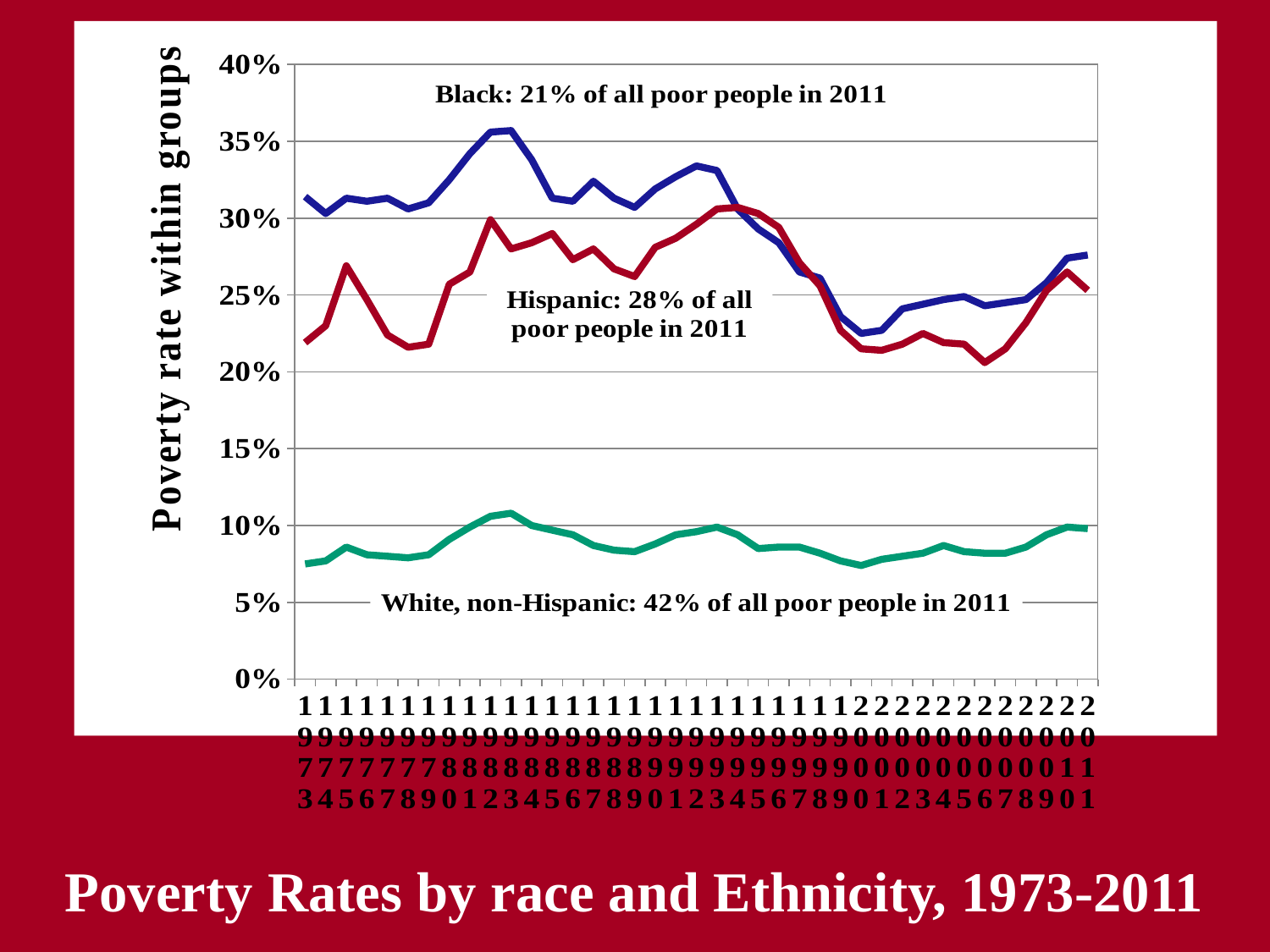
Which group has the lowest poverty rate across the whole period shown? White, non-Hispanic According to the chart annotation, what share of all poor people in 2011 were White, non-Hispanic? 42% What is the title of the slide? Poverty Rates by race and Ethnicity, 1973-2011 What kind of chart is shown on the slide? line chart What is the label on the vertical axis? Poverty rate within groups Is the poverty rate for the Black group in 1982 greater or less than 30%? greater In 1973, which group had the higher poverty rate, Black or Hispanic? Black Does the poverty rate for the Black group rise or fall between 1993 and 2000? fall According to the chart annotation, what share of all poor people in 2011 were Black? 21% How many lines (groups) are plotted on the chart? 3 Is the poverty rate for the Hispanic group in 2008 greater or less than 25%? less According to the chart annotation, what share of all poor people in 2011 were Hispanic? 28%